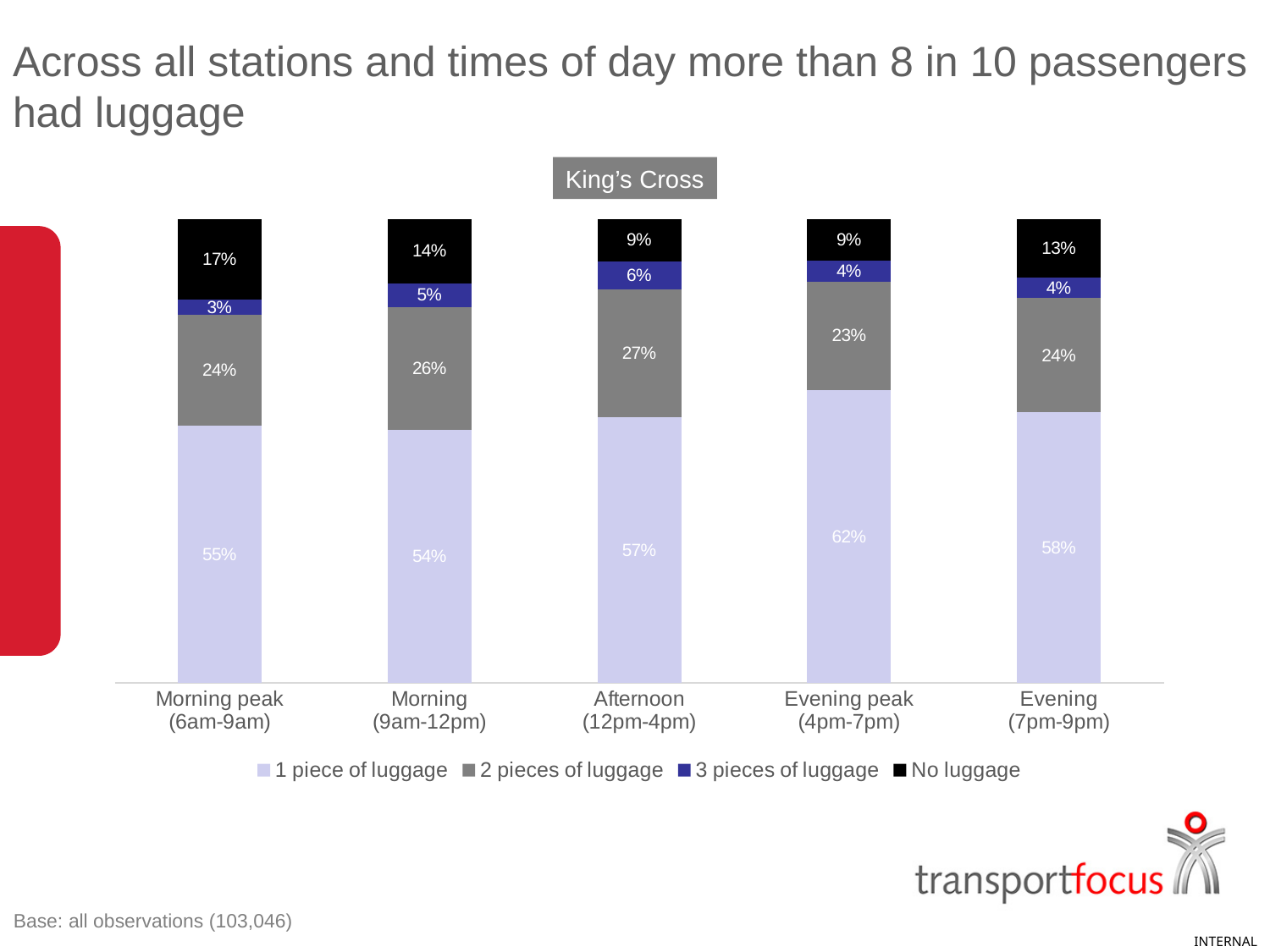
What is the difference in the share of passengers with no luggage between the Morning peak (6am-9am) and the Afternoon (12pm-4pm)? 8% What percentage of passengers at King's Cross in the Morning peak (6am-9am) had 1 piece of luggage? 55% Which time of day has the lowest share of passengers with 3 pieces of luggage? Morning peak (6am-9am) What percentage of passengers at King's Cross in the Evening (7pm-9pm) had no luggage? 13% What percentage of passengers at King's Cross in the Morning (9am-12pm) had 3 pieces of luggage? 5% How many series does the legend list? 4 What kind of chart is shown on the slide? Stacked bar chart What percentage of passengers at King's Cross in the Afternoon (12pm-4pm) had 2 pieces of luggage? 27% How many time-of-day categories are shown on the chart? 5 Which time of day has the highest share of passengers with no luggage? Morning peak (6am-9am) Which time of day has the highest share of passengers with 1 piece of luggage? Evening peak (4pm-7pm) Is the share of passengers with 2 pieces of luggage larger in the Morning (9am-12pm) or in the Evening peak (4pm-7pm)? Morning (9am-12pm)